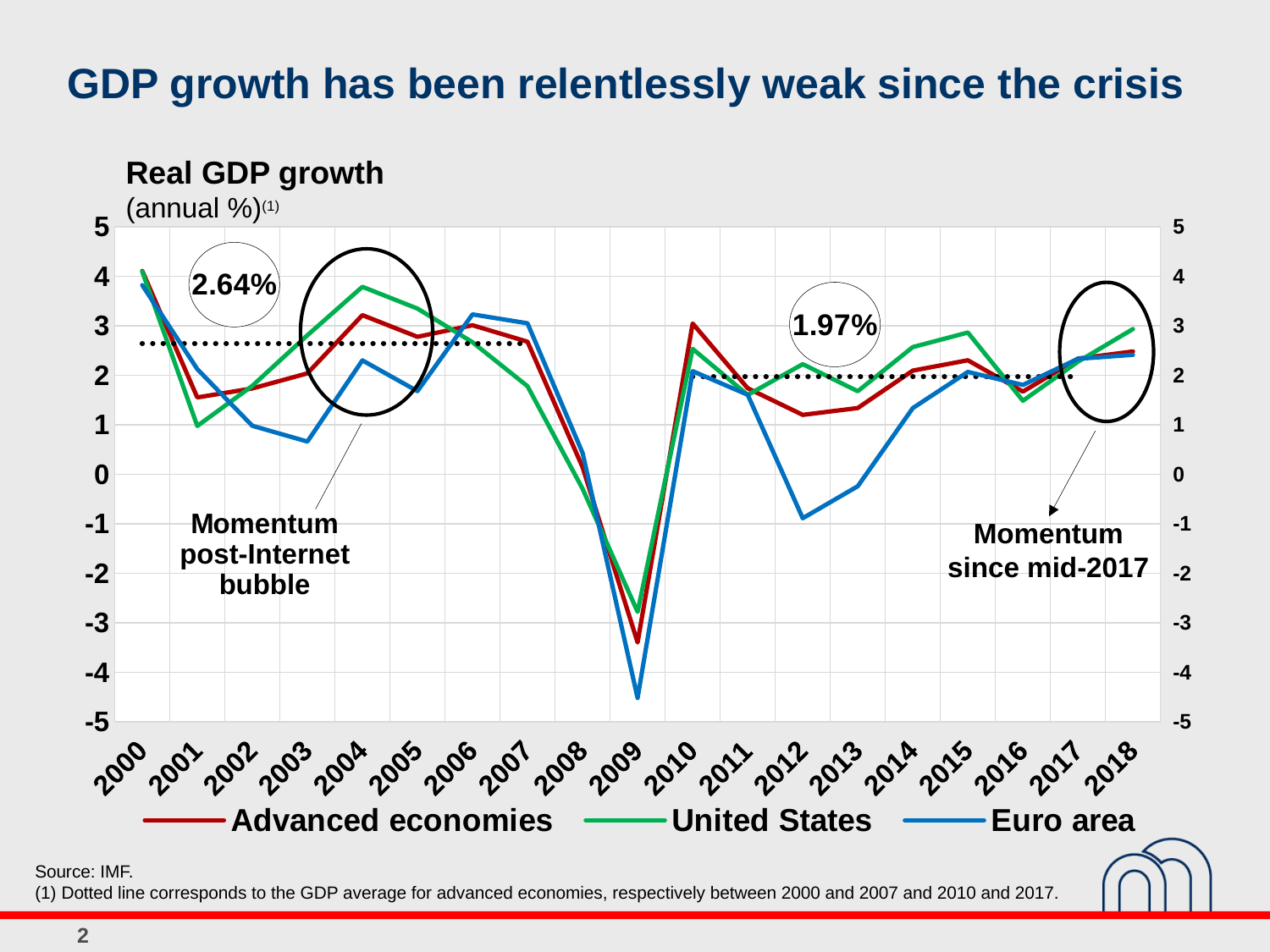
Do the values for advanced economies rise or fall from 2007 to 2009? fall In which year is the Euro area value lowest? 2009 Is the value for the Euro area in 2009 greater or less than -4? less How many series does the legend list? 3 What is the average GDP growth for advanced economies between 2010 and 2017, as shown by the dotted line label? 1.97% Which series has the highest value in 2004? United States Which series has the lowest value in 2009? Euro area How many years are shown on the x axis? 19 Is the value for the United States in 2004 greater or less than 3? greater What kind of chart is shown on the slide? line chart What is the average GDP growth for advanced economies between 2000 and 2007, as shown by the dotted line label? 2.64% Which is larger in 2012, the United States value or the Euro area value? United States